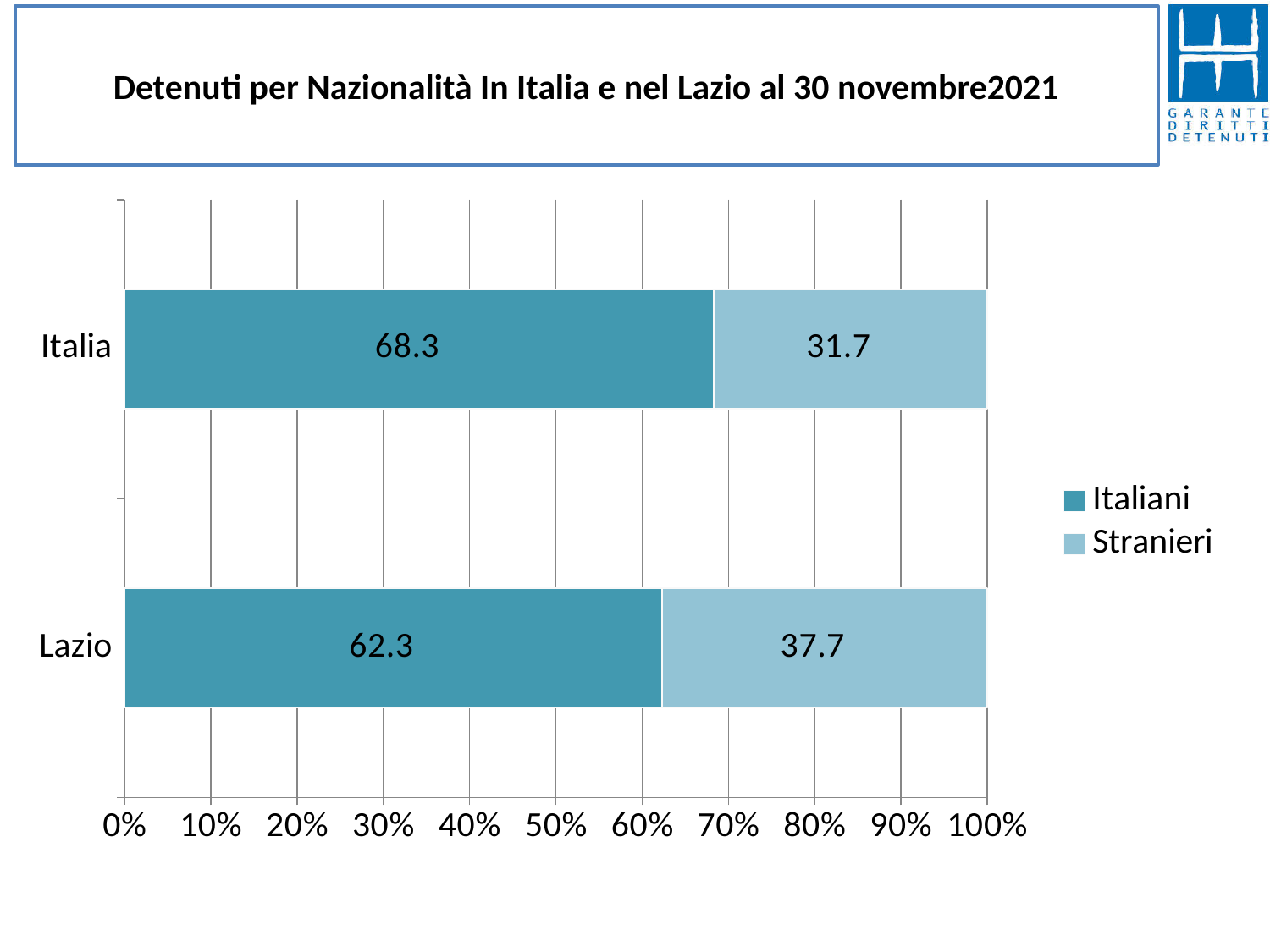
What is the value for Stranieri in Italia? 31.7 What kind of chart is shown on the slide? Stacked bar chart How many series does the legend list? 2 What is the value for Stranieri in Lazio? 37.7 What is the difference between the Stranieri and Italiani values for Lazio? 24.6 How many categories are shown on the chart? 2 What is the value for Italiani in Lazio? 62.3 What is the title of the chart? Detenuti per Nazionalità In Italia e nel Lazio al 30 novembre2021 Which category has the higher value for Stranieri, Italia or Lazio? Lazio What is the difference between the Italiani values for Italia and Lazio? 6 Which category has the higher value for Italiani, Italia or Lazio? Italia What is the value for Italiani in Italia? 68.3